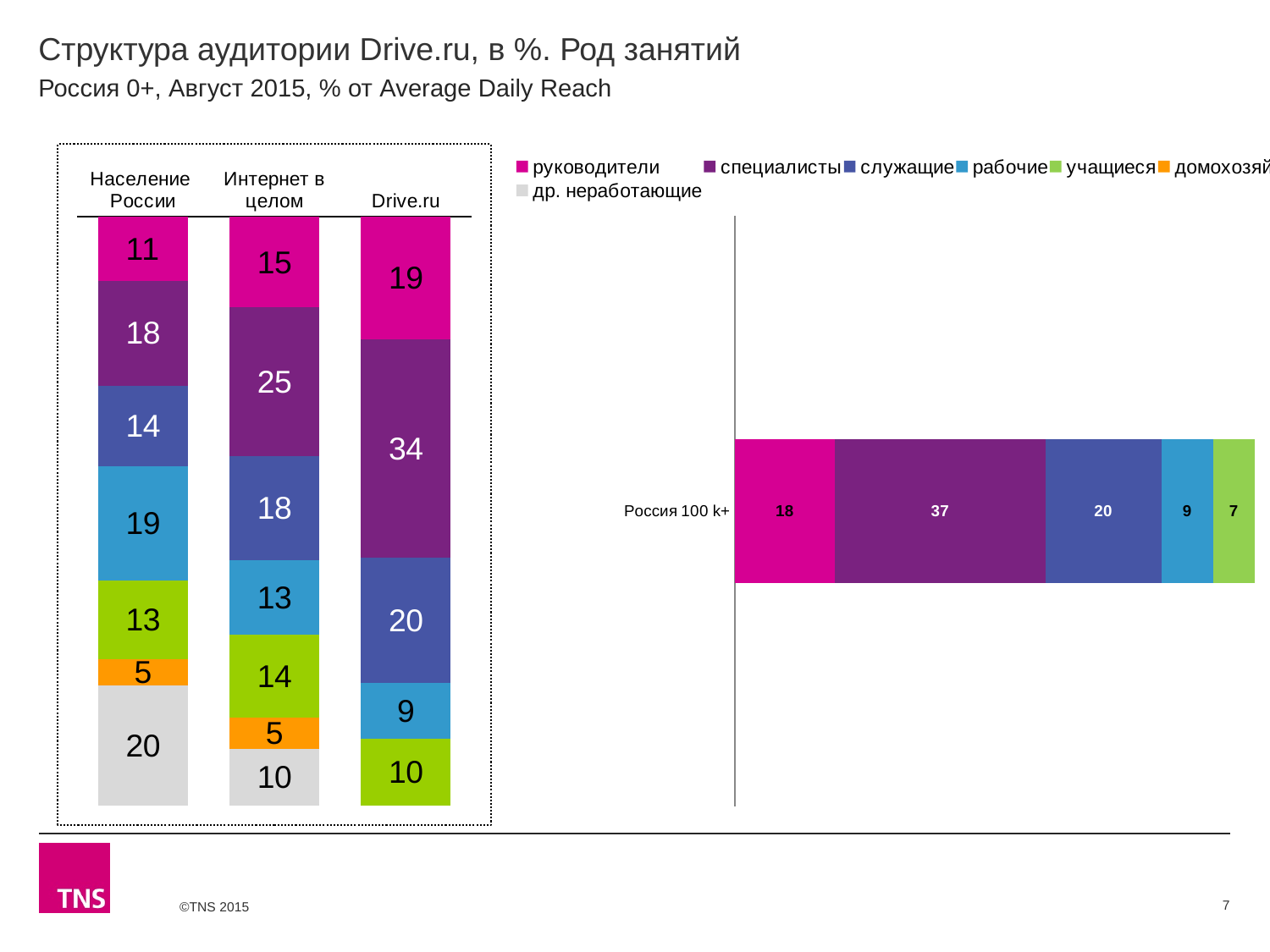
In the left chart, which segment is the largest in the Drive.ru bar? специалисты How many bars does the left chart show? 3 What kind of chart is the right chart? stacked bar chart In the right chart, what is the value for специалисты in the Россия 100 k+ bar? 37 In the left chart, what is the value for специалисты in the Drive.ru bar? 34 In the left chart, what is the difference between the специалисты values for Drive.ru and Население России? 16 How many series does the legend list? 7 In the right chart, what is the total of the Россия 100 k+ bar? 91 In the left chart, which bar has the larger value for рабочие: Население России or Drive.ru? Население России In the left chart, what is the value for др. неработающие in the Интернет в целом bar? 10 In the left chart, what is the value for руководители in the Население России bar? 11 In the left chart, which segment is the smallest in the Население России bar? домохозяйки